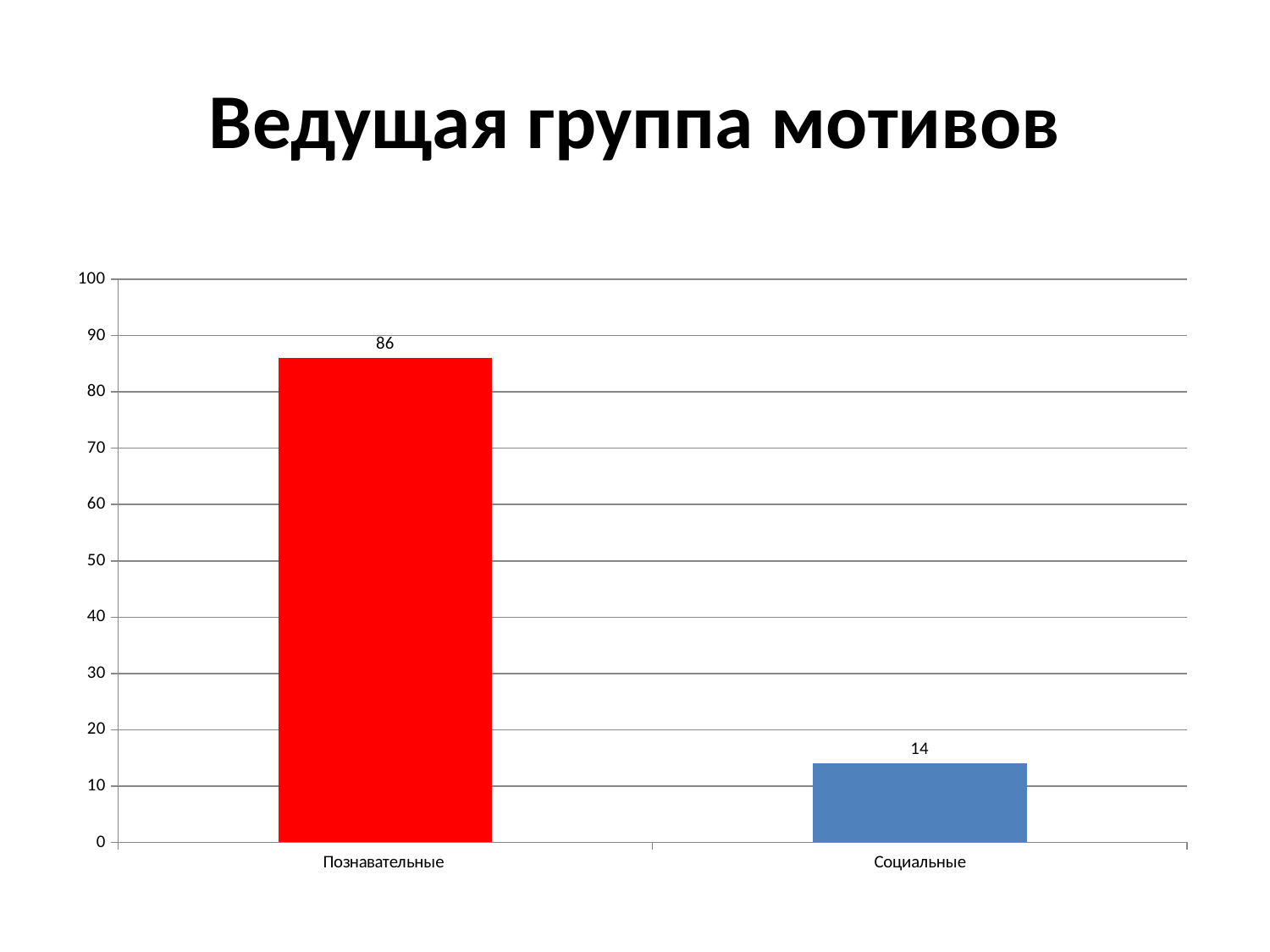
What kind of chart is shown on the slide? bar chart How many categories are shown on the chart? 2 Is the value for Познавательные greater or less than 80? greater Is the value for Социальные greater or less than 20? less Which category has the highest value? Познавательные Which is larger, the value for Познавательные or the value for Социальные? Познавательные Which category has the lowest value? Социальные What is the value for Познавательные? 86 What colour is the bar for Познавательные? red What is the value for Социальные? 14 What is the title of the slide? Ведущая группа мотивов What is the difference between the values for Познавательные and Социальные? 72